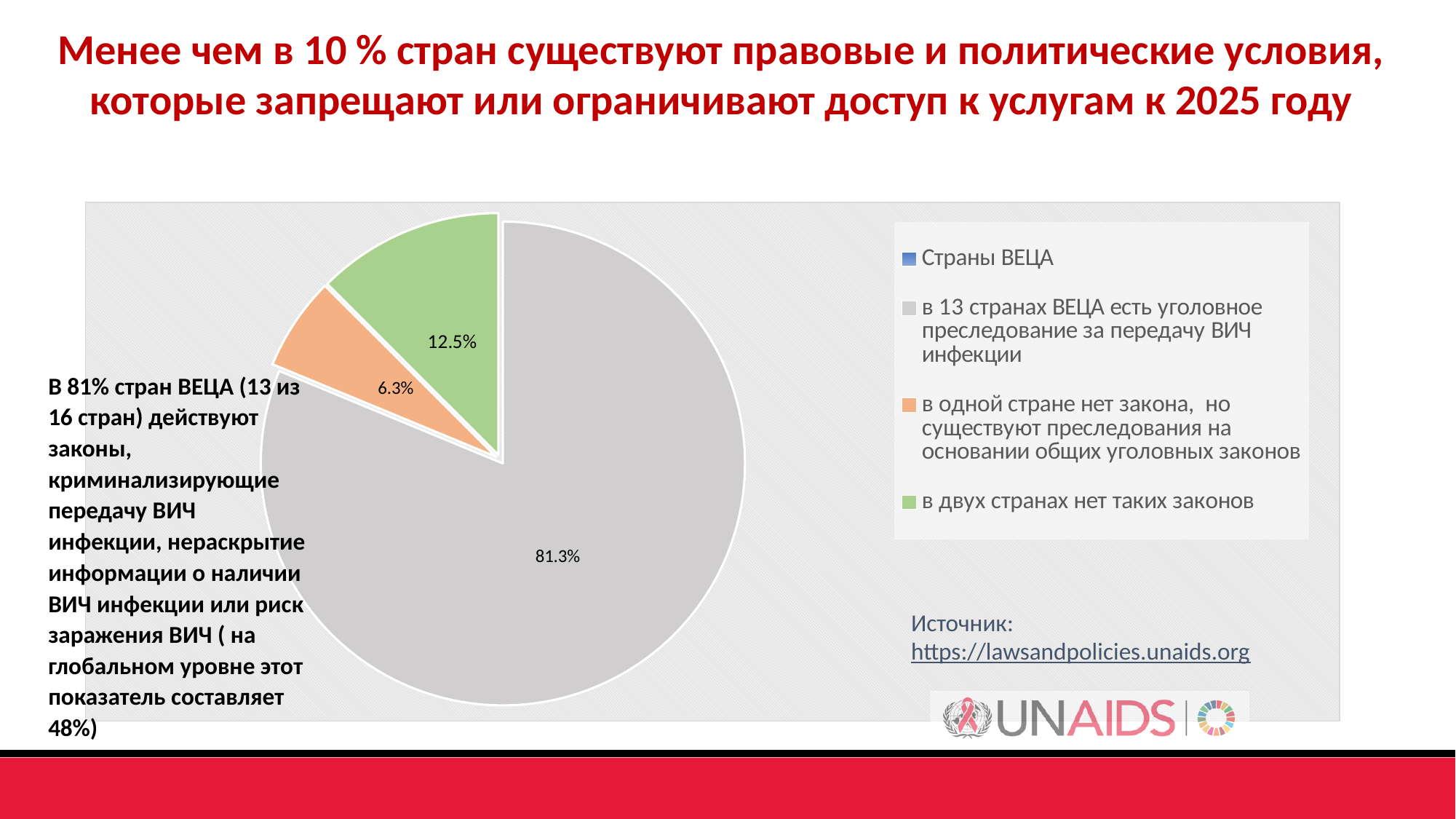
What percentage is shown for the grey slice (в 13 странах ВЕЦА есть уголовное преследование за передачу ВИЧ инфекции)? 81.3% What percentage is shown for the green slice (в двух странах нет таких законов)? 12.5% How many entries does the legend of the pie chart list? 4 What is the difference in percentage points between the green slice (12.5%) and the orange slice (6.3%)? 6.2 percentage points What is the difference in percentage points between the grey slice (81.3%) and the green slice (12.5%)? 68.8 percentage points What kind of chart is shown on the slide? pie chart Which legend category has the smallest labelled slice of the pie? в одной стране нет закона, но существуют преследования на основании общих уголовных законов Which slice is larger: the green one (в двух странах нет таких законов) or the orange one (в одной стране нет закона)? the green one (12.5%) What percentage is shown for the orange slice (в одной стране нет закона, но существуют преследования на основании общих уголовных законов)? 6.3% Which legend category has the largest slice of the pie? в 13 странах ВЕЦА есть уголовное преследование за передачу ВИЧ инфекции How many slices with percentage labels are visible in the pie chart? 3 What colour is the largest slice of the pie chart? grey